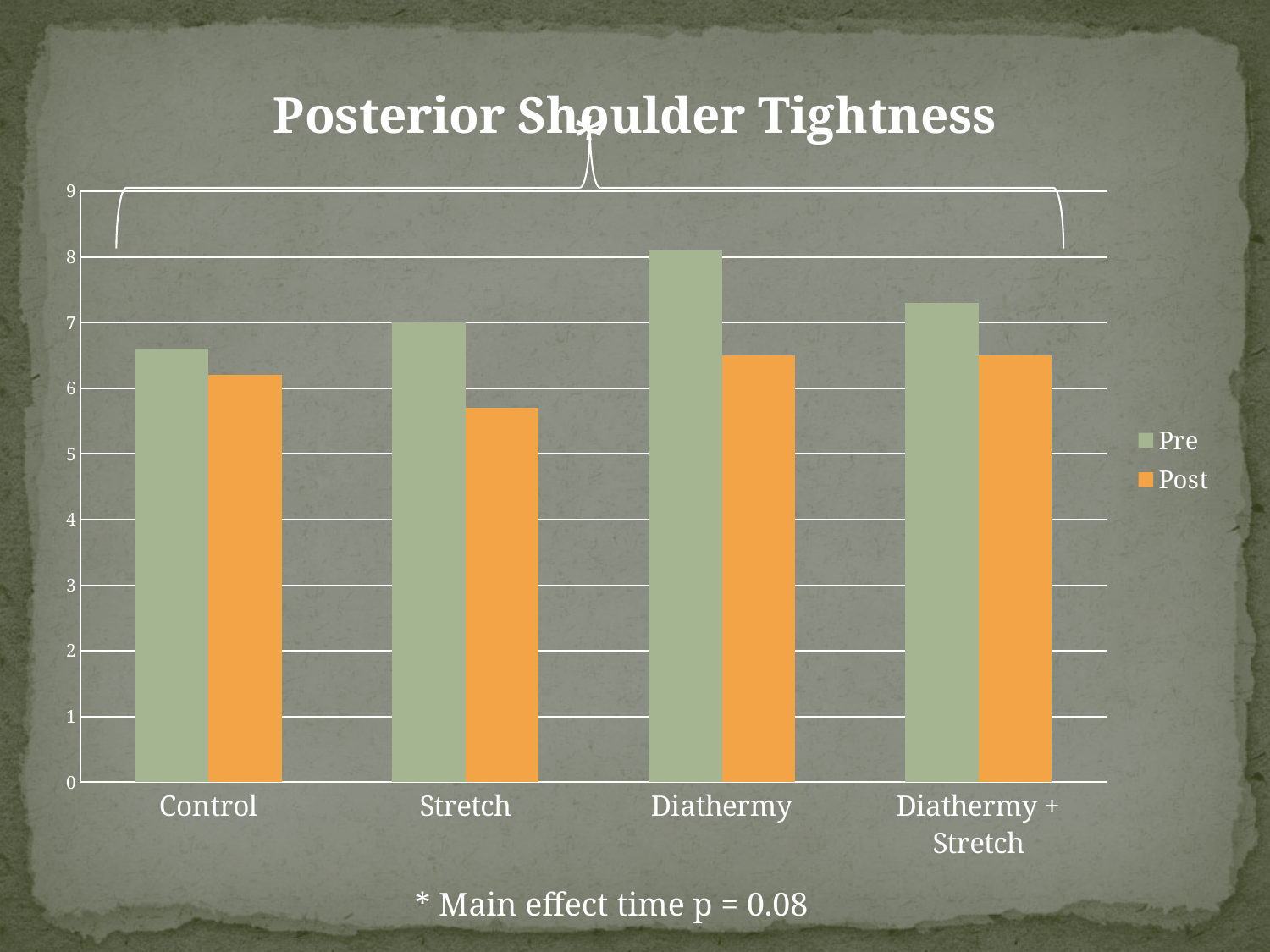
Is the Pre value for Diathermy greater or less than 8? greater How many categories are shown on the x axis? 4 What is the title of the chart? Posterior Shoulder Tightness Which category has the highest Pre value? Diathermy Is the Pre value for Diathermy + Stretch greater or less than 7? greater Which category has the lowest Post value? Stretch How many series does the legend list? 2 Which series is shown in orange? Post For Diathermy, which is larger, the Pre value or the Post value? Pre Which category has the lowest Pre value? Control What kind of chart is shown on the slide? bar chart Is the Post value for Stretch greater or less than 6? less